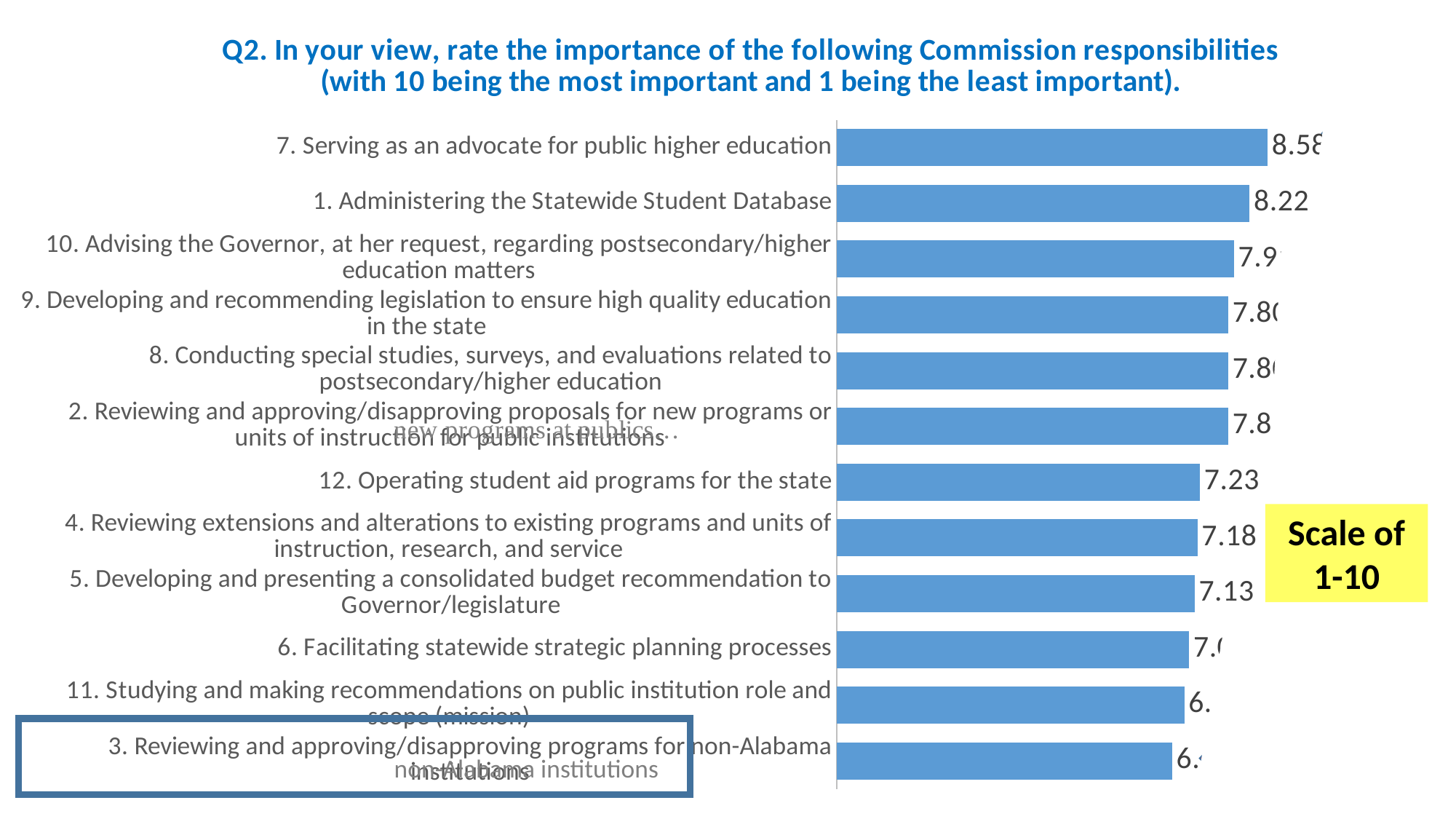
What is the difference between the ratings for '1. Administering the Statewide Student Database' and '12. Operating student aid programs for the state'? 0.99 What is the importance rating for '5. Developing and presenting a consolidated budget recommendation to Governor/legislature'? 7.13 Which has a higher rating: '1. Administering the Statewide Student Database' or '5. Developing and presenting a consolidated budget recommendation to Governor/legislature'? 1. Administering the Statewide Student Database According to the highlighted note on the slide, what scale are the ratings on? Scale of 1-10 How many Commission responsibilities are plotted in the chart? 12 Which responsibility received the lowest importance rating? 3. Reviewing and approving/disapproving programs for non-Alabama institutions What is the importance rating for '4. Reviewing extensions and alterations to existing programs and units of instruction, research, and service'? 7.18 Which responsibility received the highest importance rating? 7. Serving as an advocate for public higher education What is the importance rating for '1. Administering the Statewide Student Database'? 8.22 What kind of chart is shown on the slide? bar chart What is the importance rating for '12. Operating student aid programs for the state'? 7.23 What colour are the bars in the chart? blue